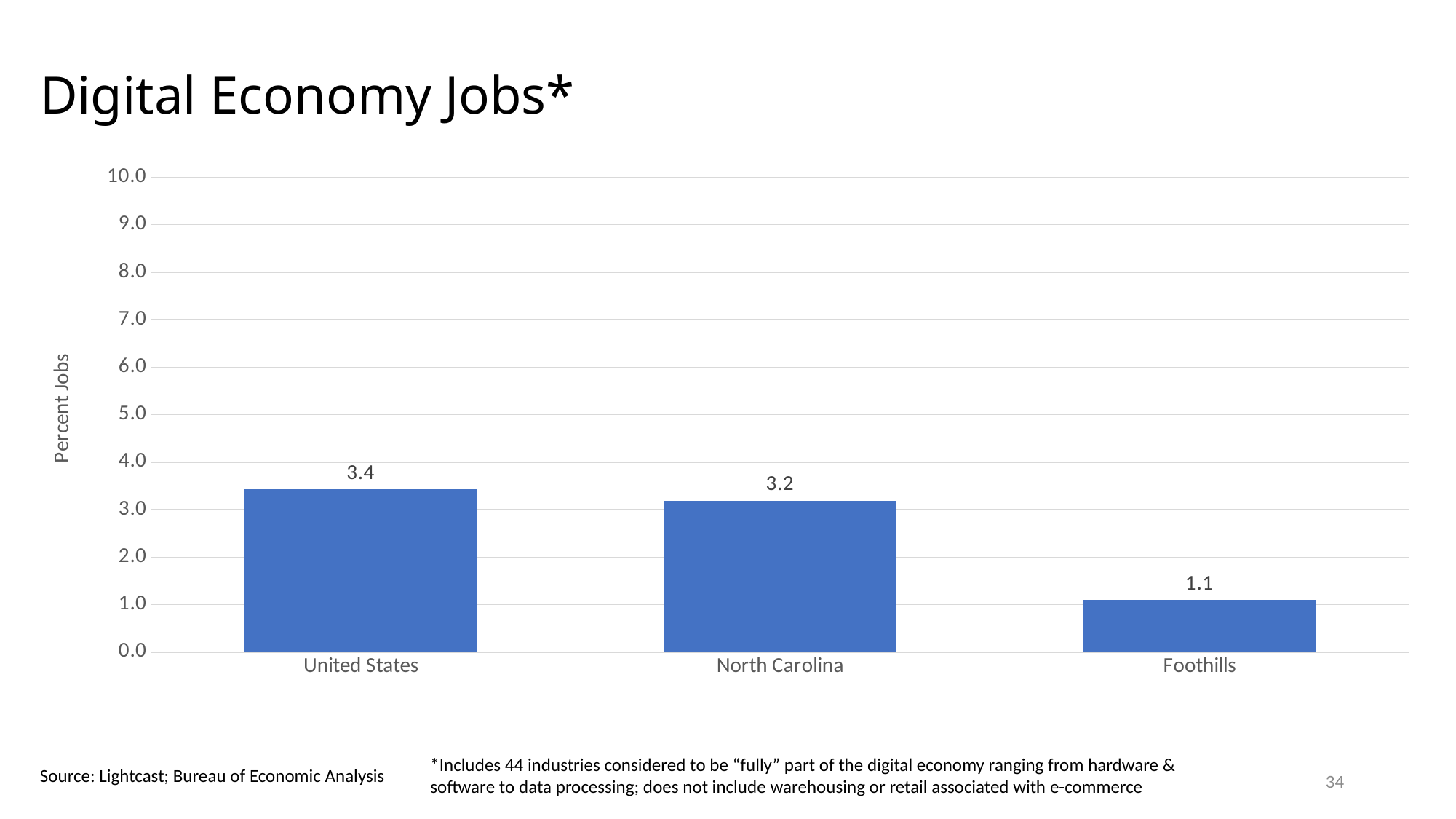
What kind of chart is shown on the slide? bar chart What is the value for North Carolina? 3.2 What is the label of the vertical axis? Percent Jobs Which category has the lowest value? Foothills Which is larger, the value for North Carolina or the value for Foothills? North Carolina What is the value for Foothills? 1.1 Which category has the highest value? United States What is the value for United States? 3.4 What is the difference between the values for United States and Foothills? 2.3 What is the difference between the values for North Carolina and Foothills? 2.1 How many categories are shown on the chart? 3 Is the value for Foothills greater or less than 2.0? less